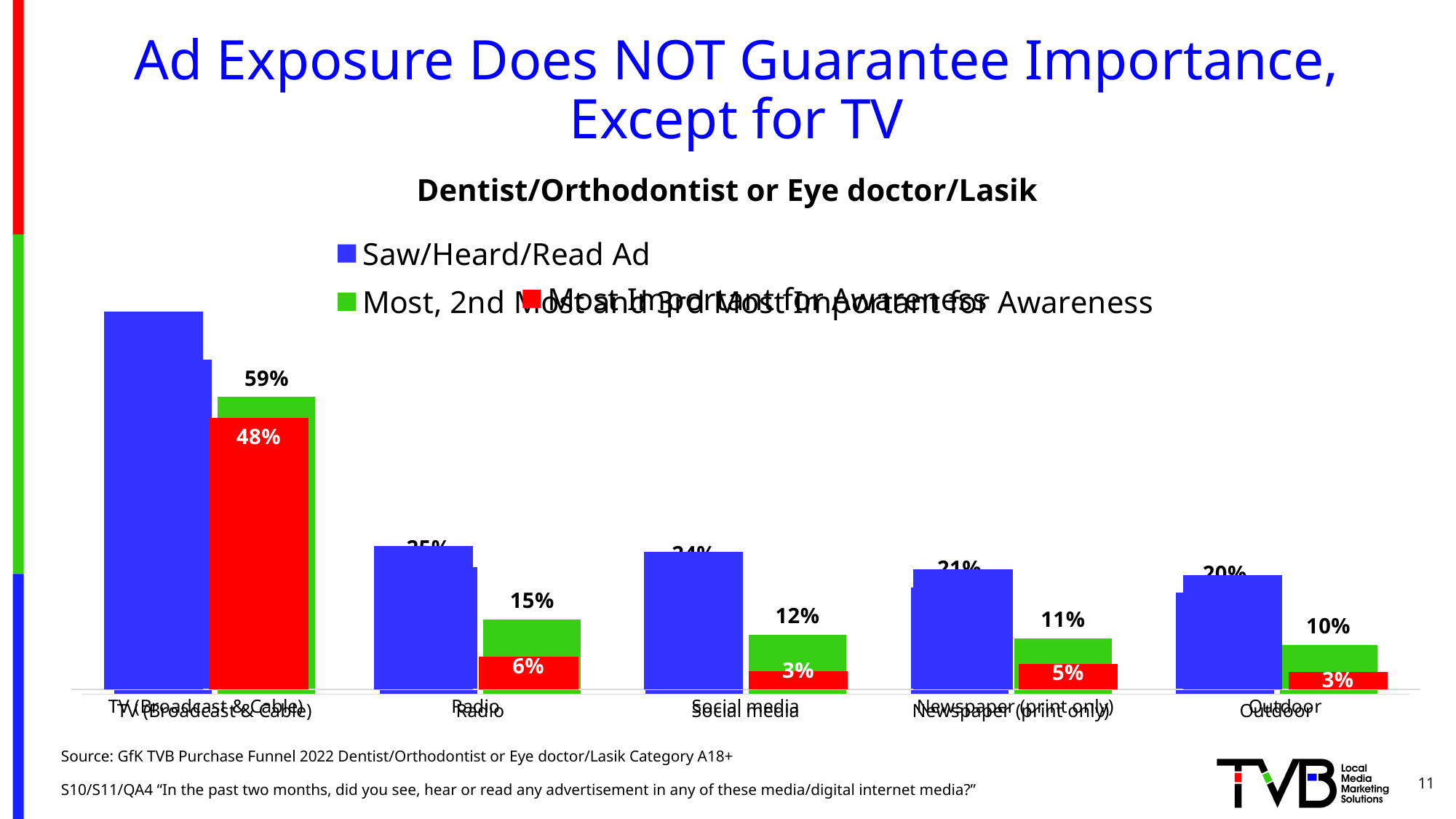
Which medium has the lowest 'Most, 2nd Most and 3rd Most Important for Awareness' value? Outdoor What is the 'Most, 2nd Most and 3rd Most Important for Awareness' value for Radio? 15% What is the difference between the green bar values for Radio (15%) and Social media (12%)? 3 percentage points What is the 'Most Important for Awareness' (red bar) value for TV (Broadcast & Cable)? 48% What is the 'Most, 2nd Most and 3rd Most Important for Awareness' value for TV (Broadcast & Cable)? 59% Which medium has the highest 'Most, 2nd Most and 3rd Most Important for Awareness' value? TV (Broadcast & Cable) What is the title of the chart? Dentist/Orthodontist or Eye doctor/Lasik Which has a higher 'Most Important for Awareness' (red bar) value: Radio or Newspaper (print only)? Radio How many media categories are shown on the x axis? 5 What type of chart is shown on the slide? Bar chart What is the difference between the green (59%) and red (48%) values for TV (Broadcast & Cable)? 11 percentage points What is the 'Most Important for Awareness' (red bar) value for Newspaper (print only)? 5%